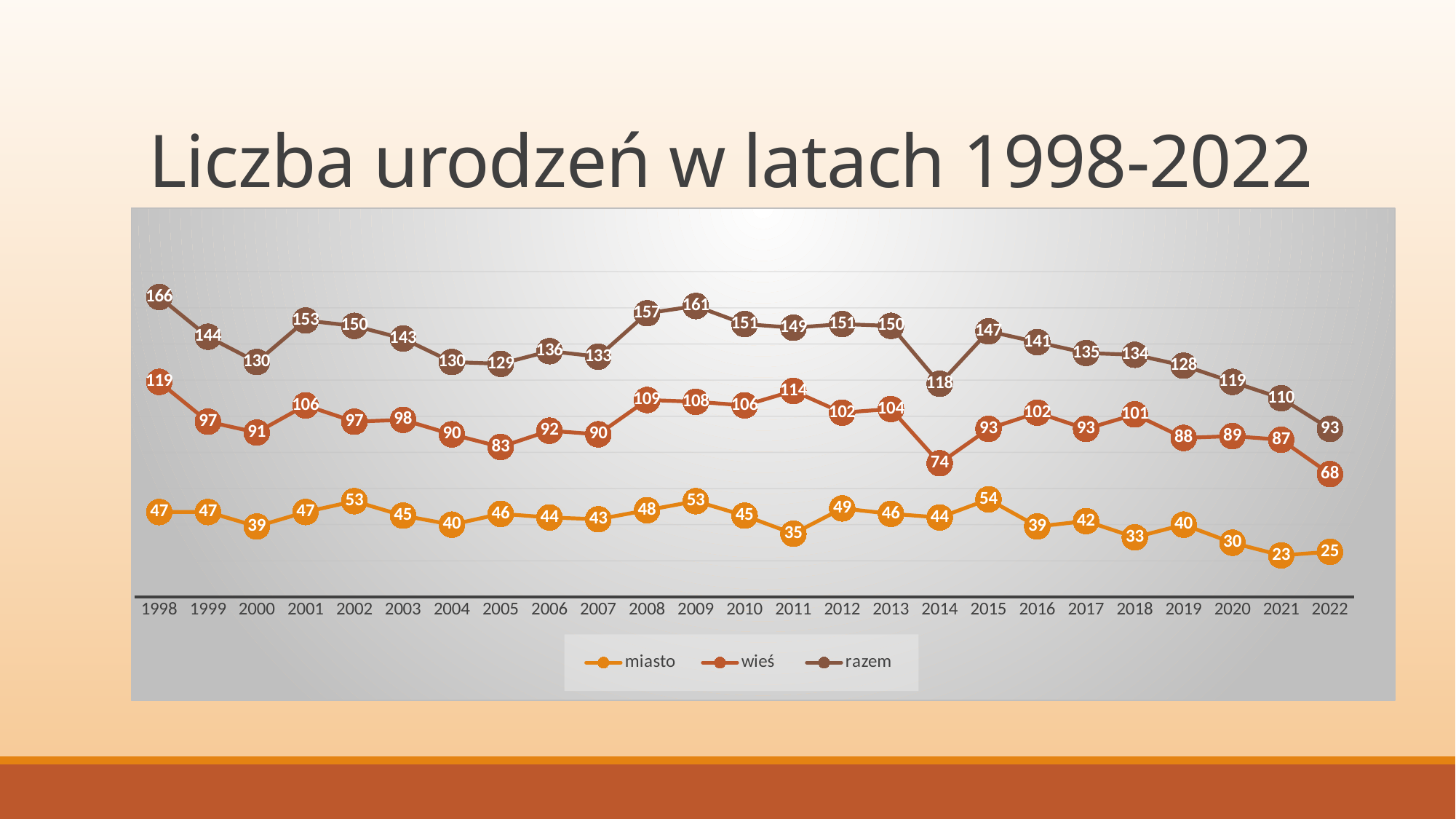
What is the value for "razem" in 1998? 166 What is the value for "wieś" in 2014? 74 Which is larger: the "wieś" value in 2011 or in 2012? 2011 What is the title of the chart? Liczba urodzeń w latach 1998-2022 What is the value for "miasto" in 2011? 35 How many years are shown on the x axis? 25 In which year is the "miasto" series lowest? 2021 What is the difference between the "razem" values for 1998 and 2022? 73 In which year is the "miasto" series highest? 2015 How many series does the legend list? 3 In which year is the "razem" series lowest? 2022 What kind of chart is shown on the slide? line chart